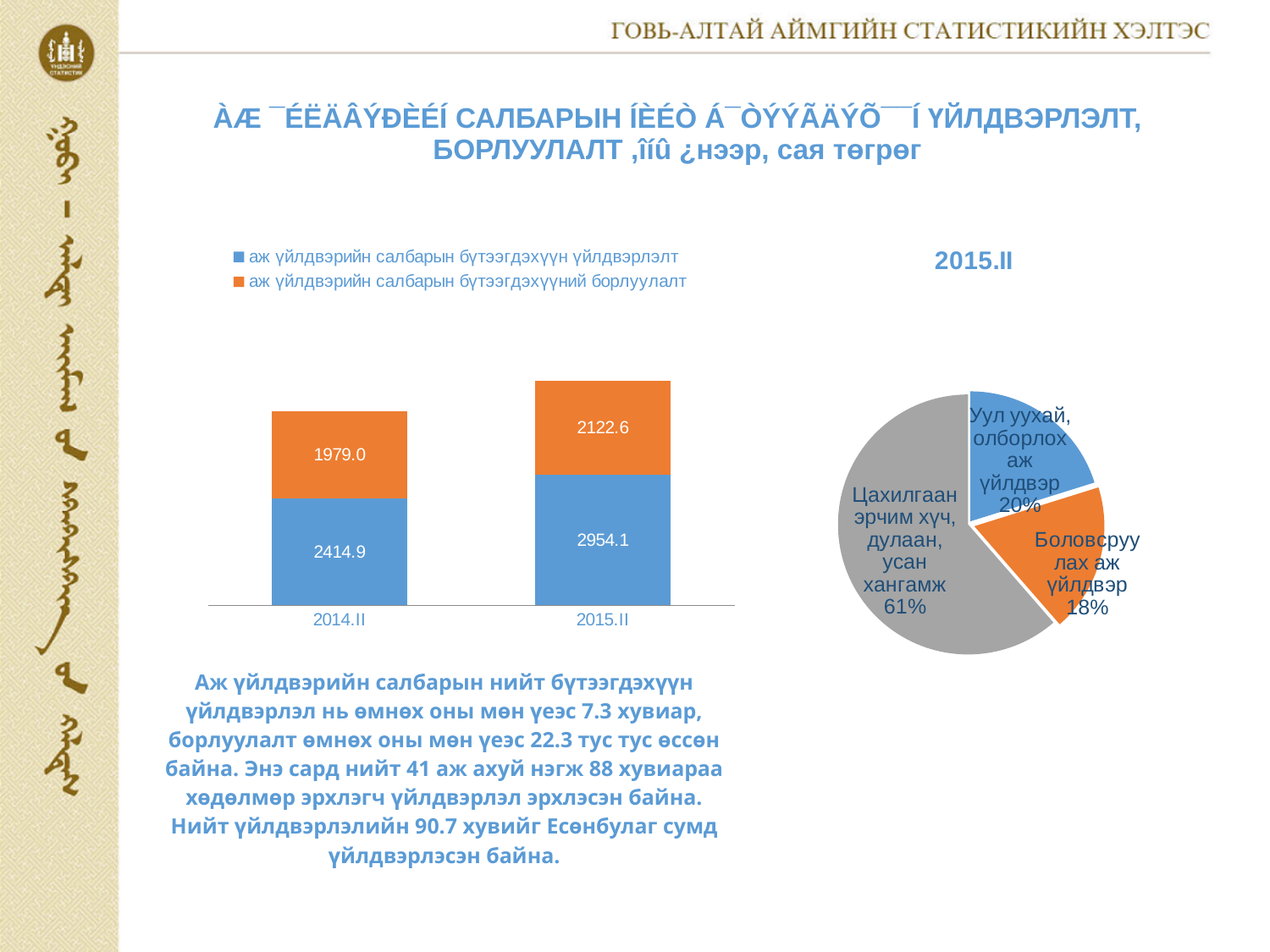
In the stacked bar chart on the left, what is the total of the 2014.II bar? 4393.9 What kind of chart is the chart on the left of the slide? Stacked bar chart How many slices does the pie chart titled 2015.II have? 3 In the stacked bar chart on the left, what is the value of аж үйлдвэрийн салбарын бүтээгдэхүүний борлуулалт for 2015.II? 2122.6 In the stacked bar chart on the left, what is the difference between the үйлдвэрлэлт values for 2015.II and 2014.II? 539.2 In the stacked bar chart on the left, what is the value of аж үйлдвэрийн салбарын бүтээгдэхүүн үйлдвэрлэлт for 2015.II? 2954.1 In the pie chart titled 2015.II, which slice is the smallest? Боловсруулах аж үйлдвэр In the stacked bar chart on the left, what is the value of аж үйлдвэрийн салбарын бүтээгдэхүүний борлуулалт for 2014.II? 1979.0 How many series does the legend of the stacked bar chart on the left list? 2 In the stacked bar chart on the left, which period has the larger борлуулалт value, 2014.II or 2015.II? 2015.II In the stacked bar chart on the left, what is the total of the 2015.II bar? 5076.7 In the pie chart titled 2015.II, what share does Цахилгаан эрчим хүч, дулаан, усан хангамж have? 61%